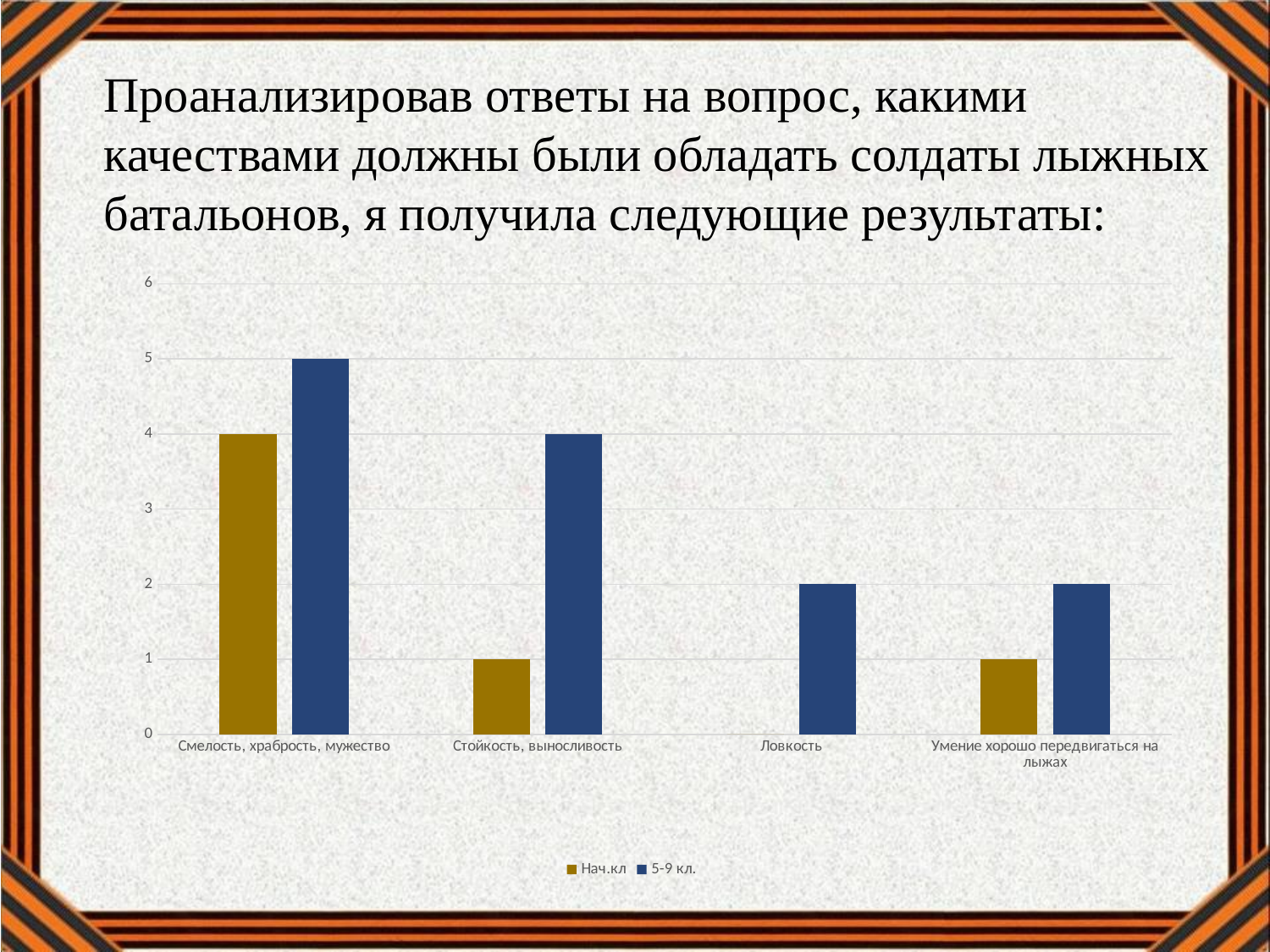
Which category has the highest value for the 5-9 кл. series? Смелость, храбрость, мужество What is the value for 5-9 кл. in the category Ловкость? 2 Which series is shown in blue in the legend? 5-9 кл. What kind of chart is shown on the slide? bar chart Which category has the lowest value for the 5-9 кл. series? Ловкость and Умение хорошо передвигаться на лыжах (both 2) What is the difference between the 5-9 кл. and Нач.кл values for Стойкость, выносливость? 3 What is the value for 5-9 кл. in the category Смелость, храбрость, мужество? 5 Which is larger for Смелость, храбрость, мужество: the Нач.кл value or the 5-9 кл. value? 5-9 кл. How many series does the legend list? 2 What is the value for Нач.кл in the category Смелость, храбрость, мужество? 4 What is the value for 5-9 кл. in the category Стойкость, выносливость? 4 How many categories are shown on the x axis? 4